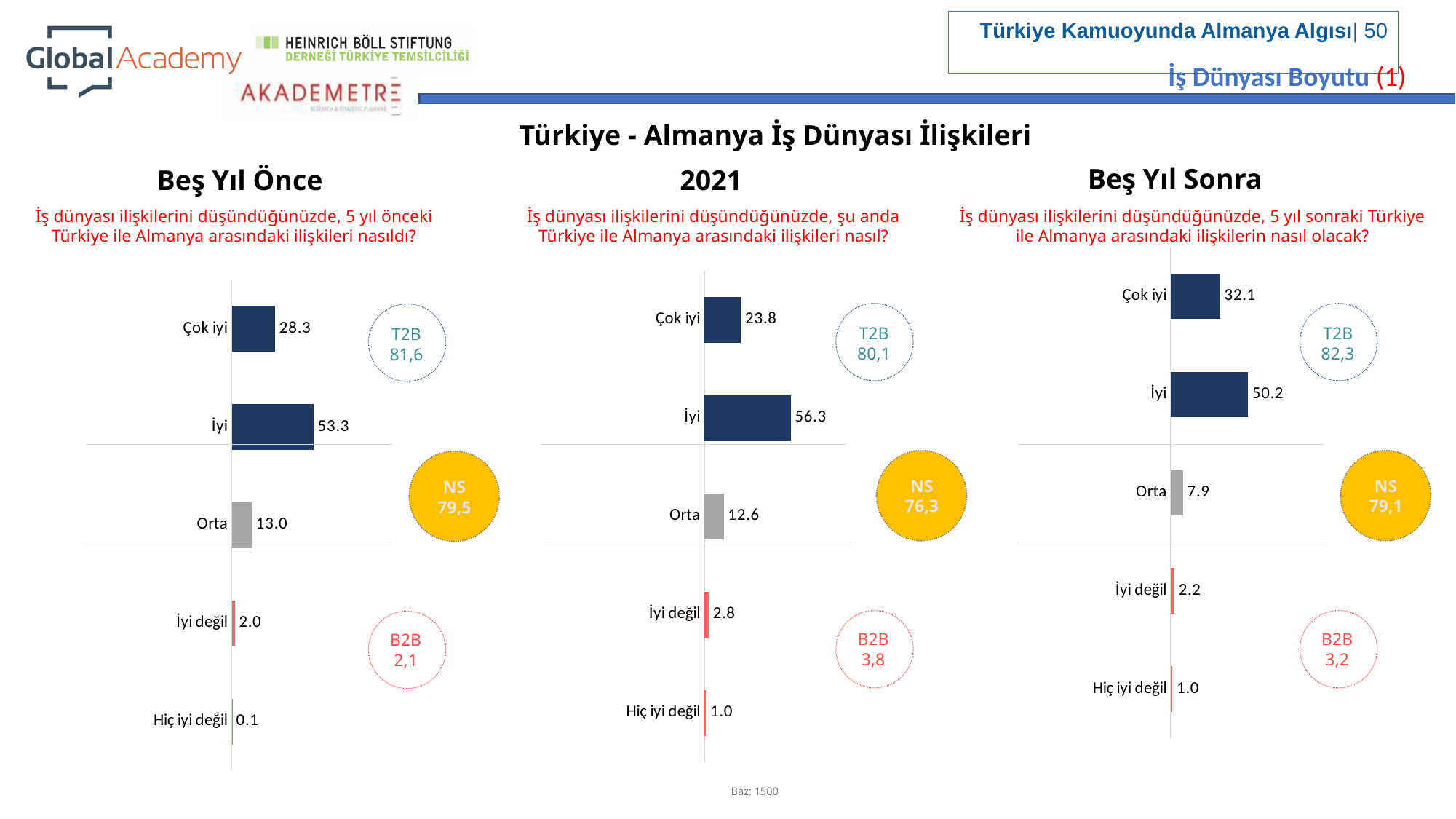
In the 'Beş Yıl Önce' chart, which category has the highest value? İyi What is the T2B value shown next to the 'Beş Yıl Sonra' chart? 82,3 In the '2021' chart, what is the value for 'Çok iyi'? 23.8 What kind of chart is the '2021' chart? Bar chart In the '2021' chart, which category has the lowest value? Hiç iyi değil In the 'Beş Yıl Sonra' chart, what is the difference between the values for 'İyi' and 'Çok iyi'? 18.1 How many categories are shown in the 'Beş Yıl Önce' chart? 5 What is the NS value shown next to the '2021' chart? 76,3 In the 'Beş Yıl Önce' chart, what is the difference between the values for 'Orta' and 'İyi değil'? 11.0 In the '2021' chart, which is larger: the value for 'Orta' or the value for 'İyi değil'? Orta In the 'Beş Yıl Önce' chart, what is the value for 'İyi'? 53.3 In the 'Beş Yıl Sonra' chart, what is the value for 'Orta'? 7.9